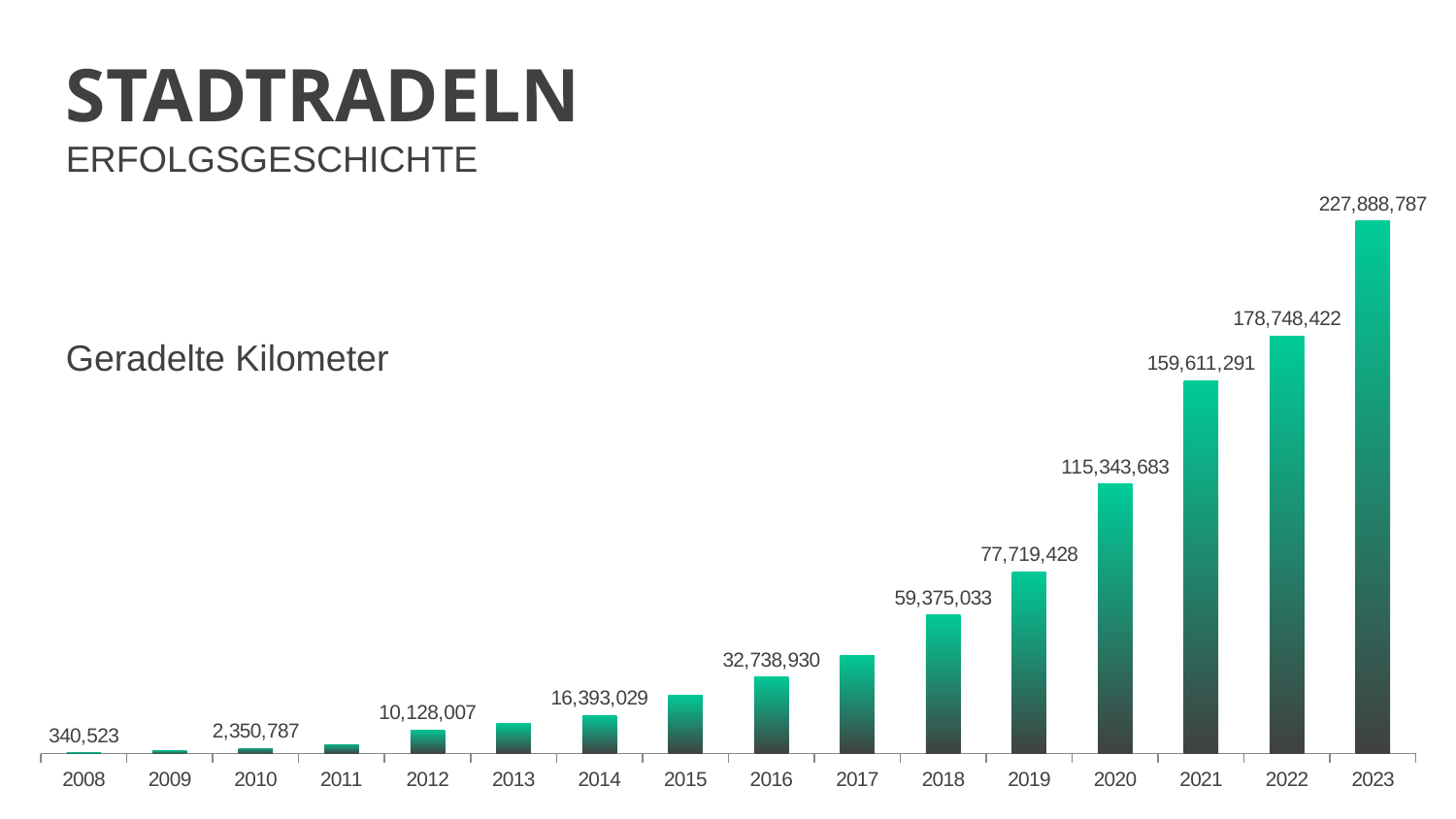
Which year has the highest value? 2023 What value is shown for 2020? 115,343,683 What kind of chart is shown? Bar chart Which year has the lowest value? 2008 What is the difference between the values for 2023 and 2022? 49,140,365 What value is shown for 2023? 227,888,787 What value is shown for 2008? 340,523 What is the difference between the values for 2021 and 2020? 44,267,608 Do the values rise or fall from 2008 to 2023? Rise Which is larger, the value for 2019 or the value for 2018? 2019 How many years are shown on the x axis? 16 What value is shown for 2016? 32,738,930